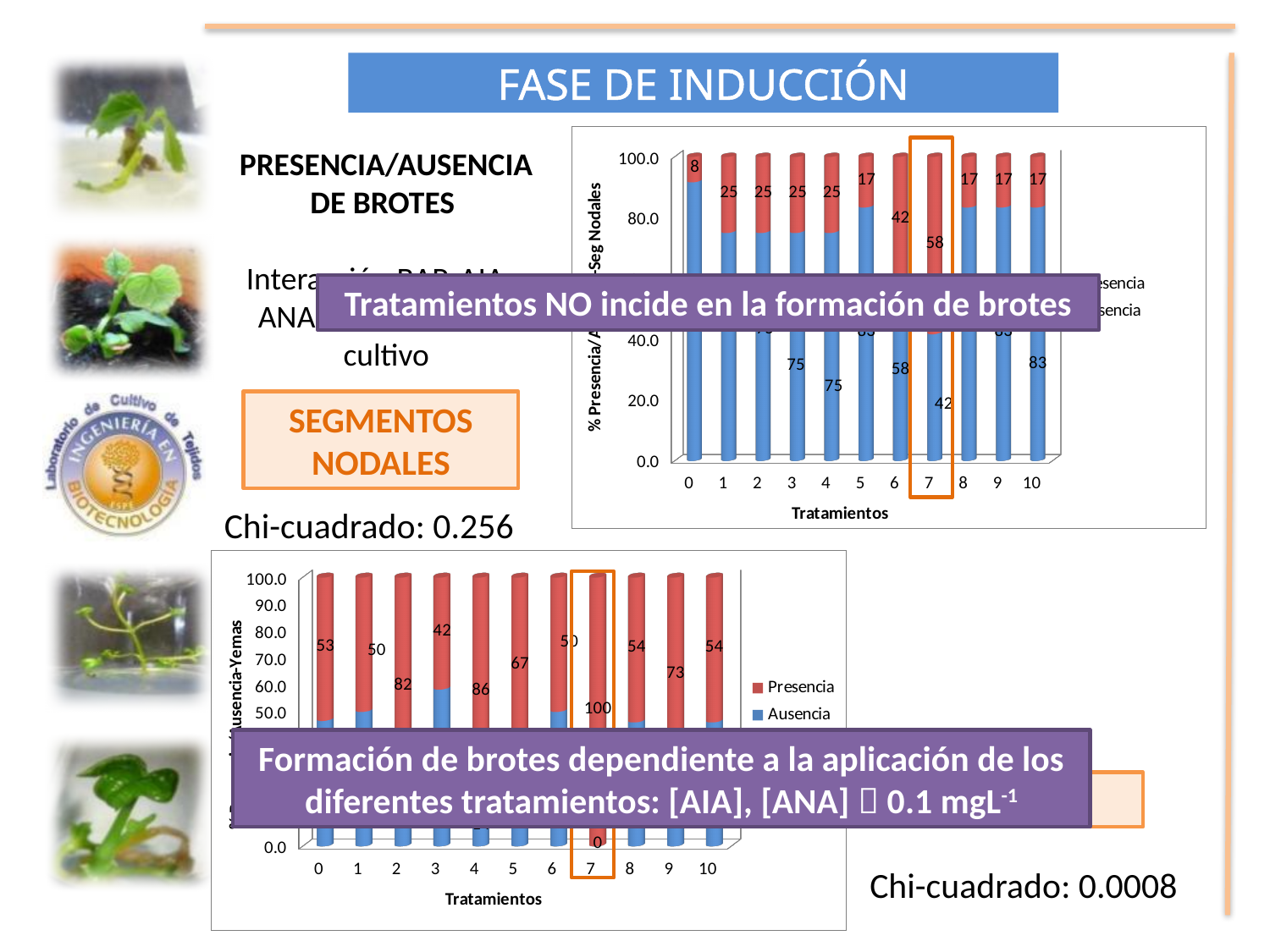
In the bottom chart (Yemas), what is the difference between the Presencia values for treatment 2 and treatment 3? 40 In the top chart (Seg Nodales), what is the total of the stacked bar for treatment 7 (Presencia plus Ausencia)? 100 In the top chart (Seg Nodales), what is the Ausencia value for treatment 10? 83 In the top chart (Seg Nodales), what is the Presencia value for treatment 7? 58 In the bottom chart (Yemas), what is the Ausencia value for treatment 7? 0 In the bottom chart (Yemas), which treatment has the lowest Presencia value? 3 In the bottom chart (Yemas), what is the Presencia value for treatment 7? 100 In the top chart (Seg Nodales), how many treatments are shown on the x axis? 11 In the top chart (Seg Nodales), what is the Presencia value for treatment 6? 42 In the bottom chart (Yemas), how many series does the legend list? 2 In the top chart (Seg Nodales), which treatment has the highest Presencia value? 7 What kind of chart is the top chart (Seg Nodales)? Stacked bar chart